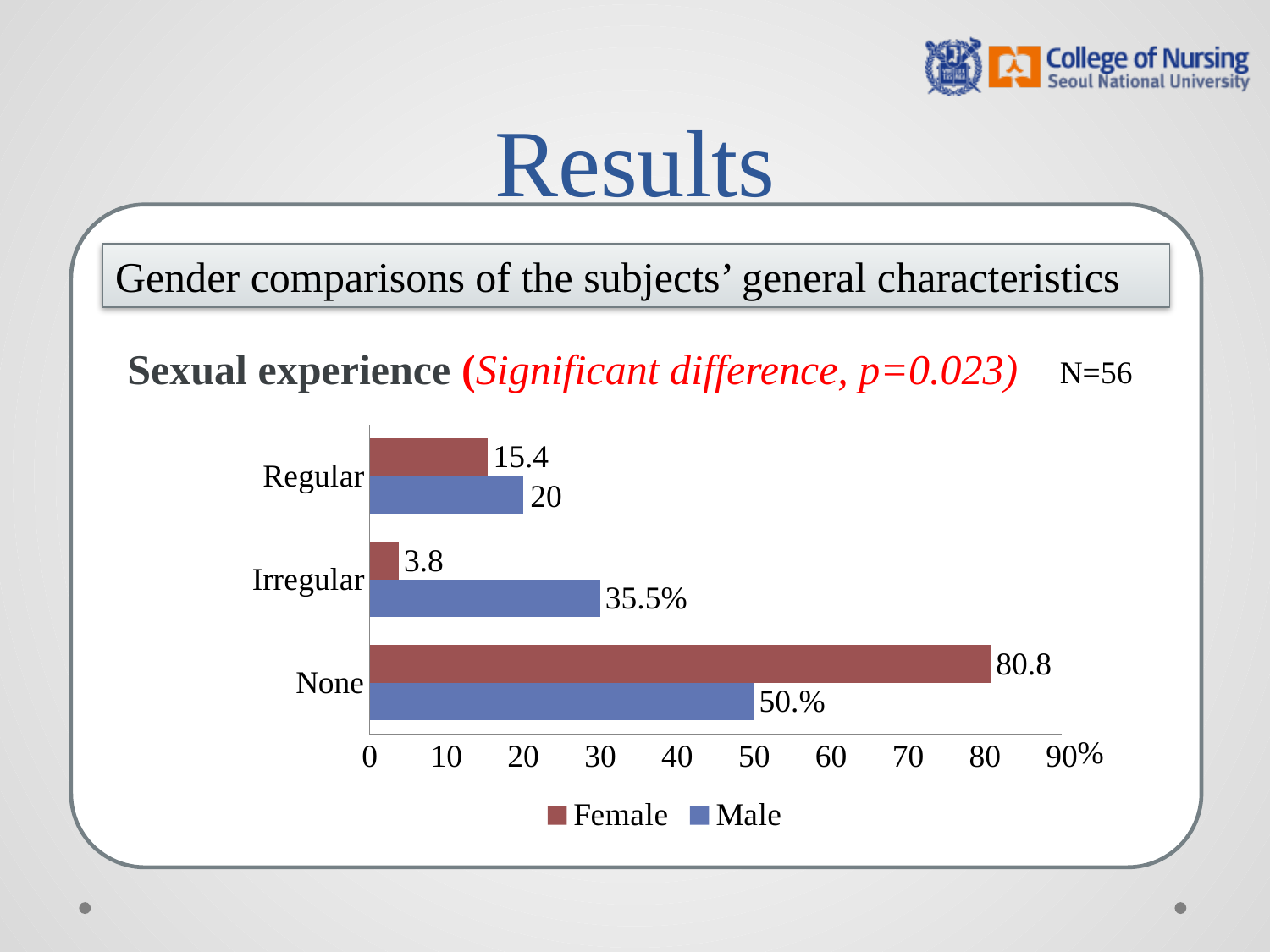
For the Irregular category, which is larger, the Female value or the Male value? Male What is the difference between the Male and Female values for the Regular category? 4.6 What kind of chart is shown on the slide? Bar chart How many categories are shown on the chart? 3 How many series does the legend list? 2 Which category has the highest Female value? None What is the Male value for the Irregular category? 35.5% What is the Female value for the Regular category? 15.4 What is the Male value for the None category? 50.% Which category has the lowest Female value? Irregular What is the Female value for the None category? 80.8 What is the difference between the Female and Male values for the None category? 30.8